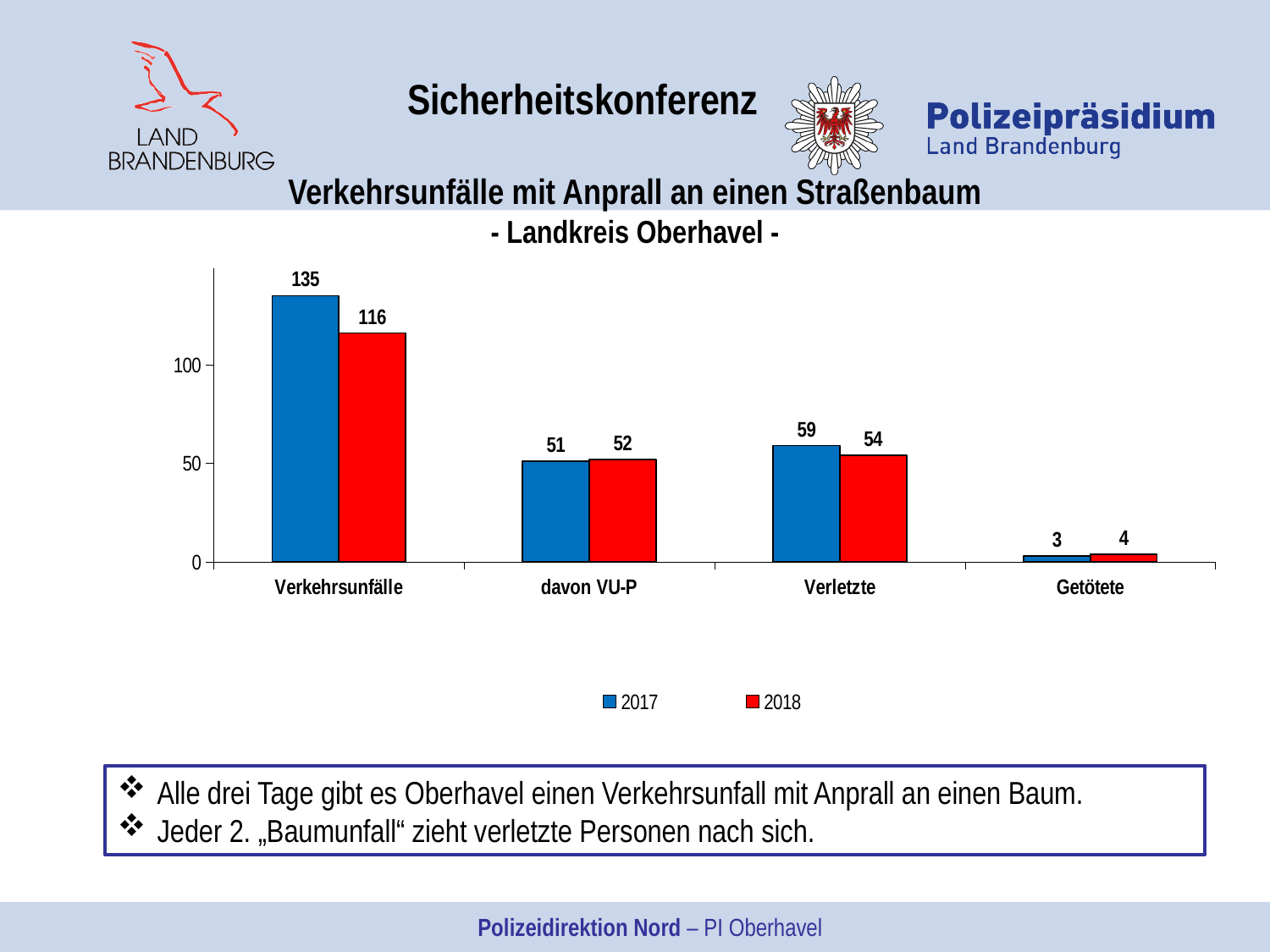
Is the value for Verkehrsunfälle in 2018 greater or less than 100? greater What is the value for Verkehrsunfälle in 2017? 135 What is the value for Verletzte in 2018? 54 Which is larger for davon VU-P: the 2017 value or the 2018 value? 2018 How many categories are shown on the x axis? 4 What is the value for Getötete in 2017? 3 Which category has the lowest value in 2017? Getötete Which category has the highest value in 2018? Verkehrsunfälle Which colour represents the 2018 series? red What kind of chart is shown on the slide? bar chart What is the difference between the 2017 and 2018 values for Verkehrsunfälle? 19 How many series does the legend list? 2